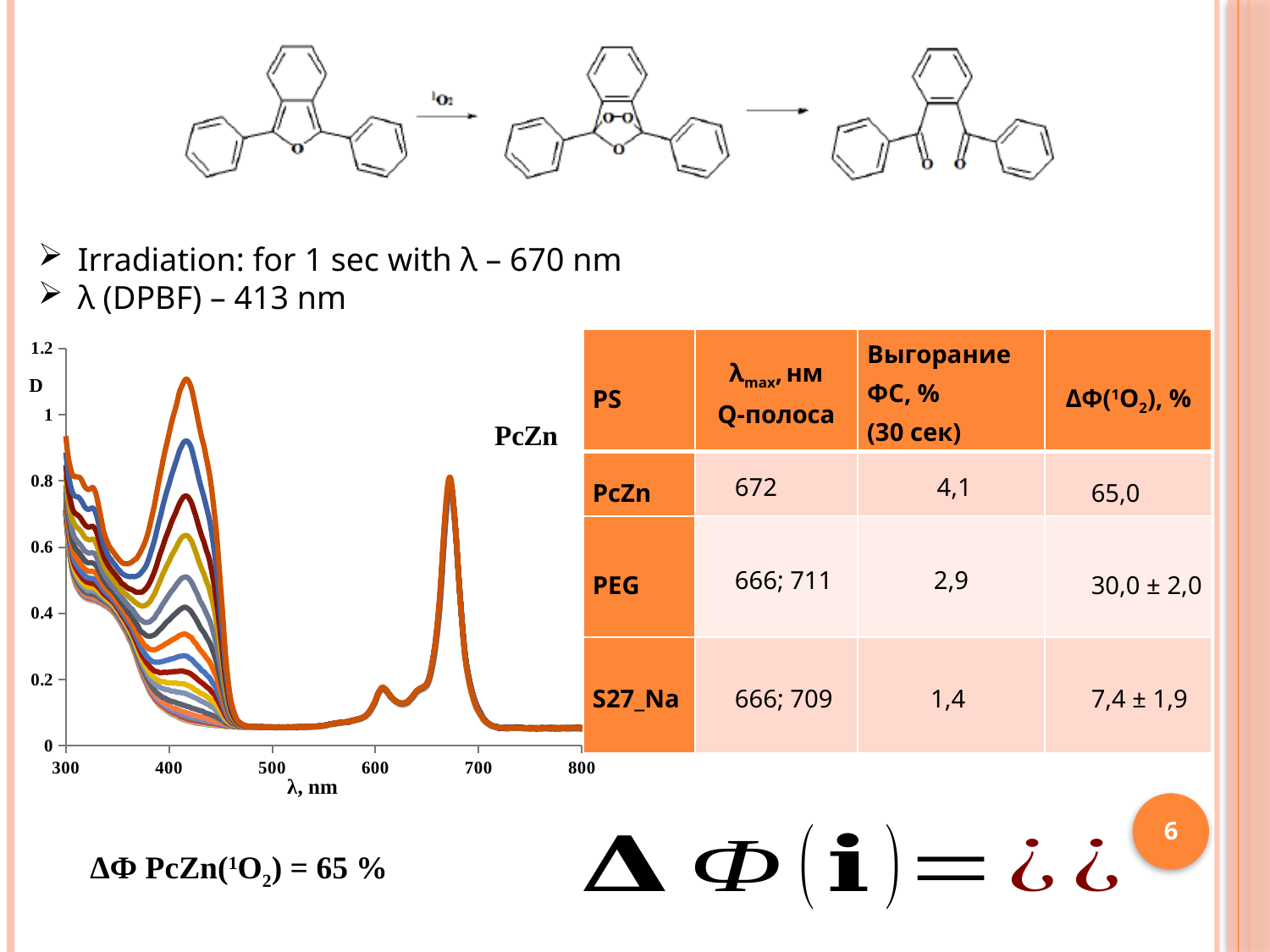
What kind of chart is shown on the left of the slide? line chart Is the small peak near 610 nm greater or less than 0.4? less What is the label of the y axis of the spectrum chart? D Which peak of the tallest curve is higher: the one near 415 nm or the one near 670 nm? the one near 415 nm Do the curves rise or fall between 420 nm and 470 nm? fall What is the label of the x axis of the spectrum chart? λ, nm Is the value of the curves at their peak near 670 nm greater or less than 1? less Is the value of the curves at 550 nm greater or less than 0.2? less Do the curves rise or fall between 620 nm and 670 nm? rise